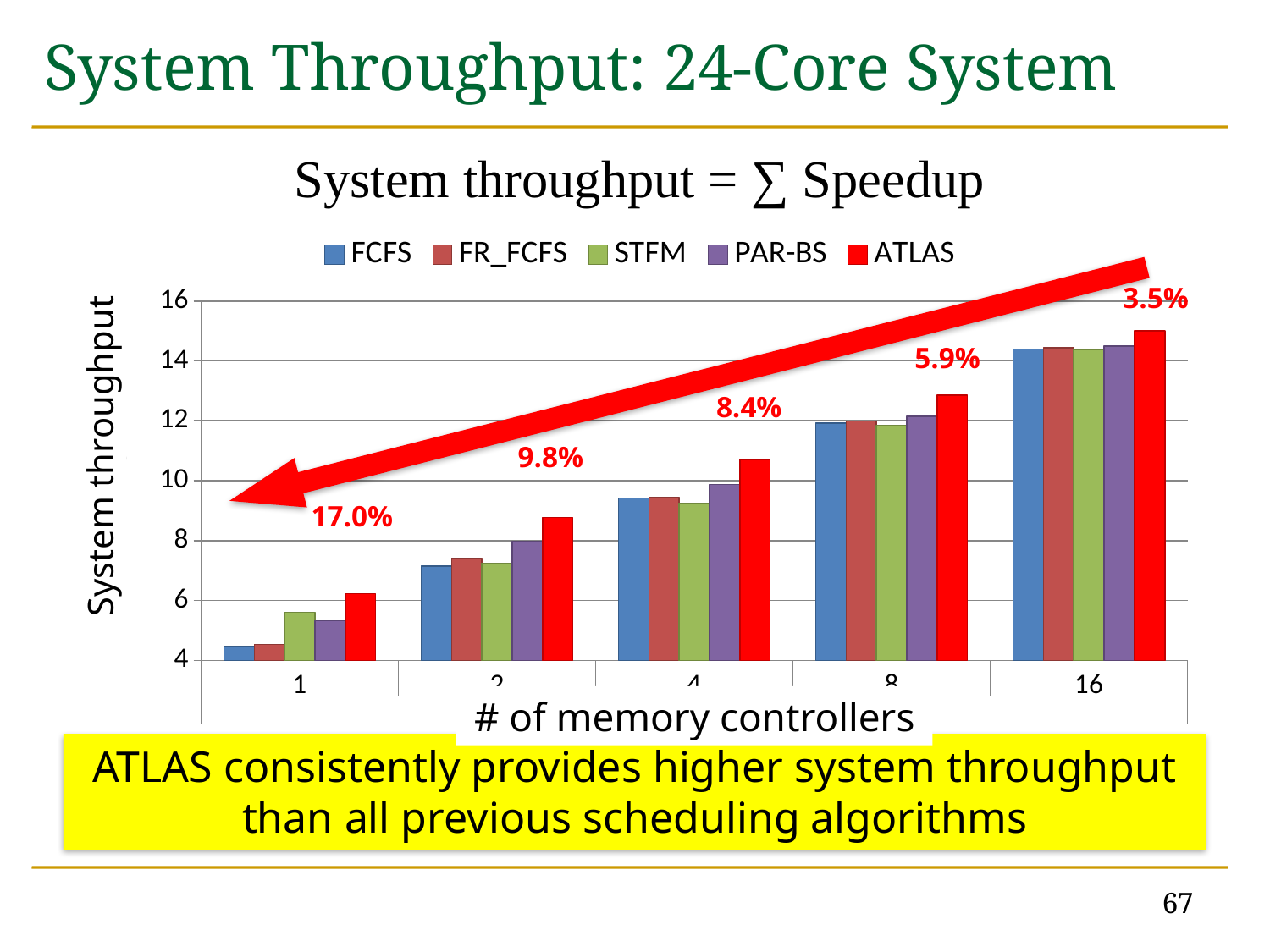
Which series has the lowest system throughput at 1 memory controller? FCFS What is the label of the y axis? System throughput Is the FCFS value at 16 memory controllers greater or less than 14? greater How many series does the legend list? 5 Which series has the highest system throughput at 16 memory controllers? ATLAS Is the ATLAS value at 16 memory controllers greater or less than 16? less What percentage improvement is annotated above the bars for 1 memory controller? 17.0% What kind of chart is shown on the slide? bar chart At 1 memory controller, which is larger: the STFM value or the FCFS value? STFM Is the ATLAS value at 1 memory controller greater or less than 6? greater Does the ATLAS system throughput rise or fall as the number of memory controllers increases? rise How many groups of bars (memory controller counts) are plotted along the x axis? 5